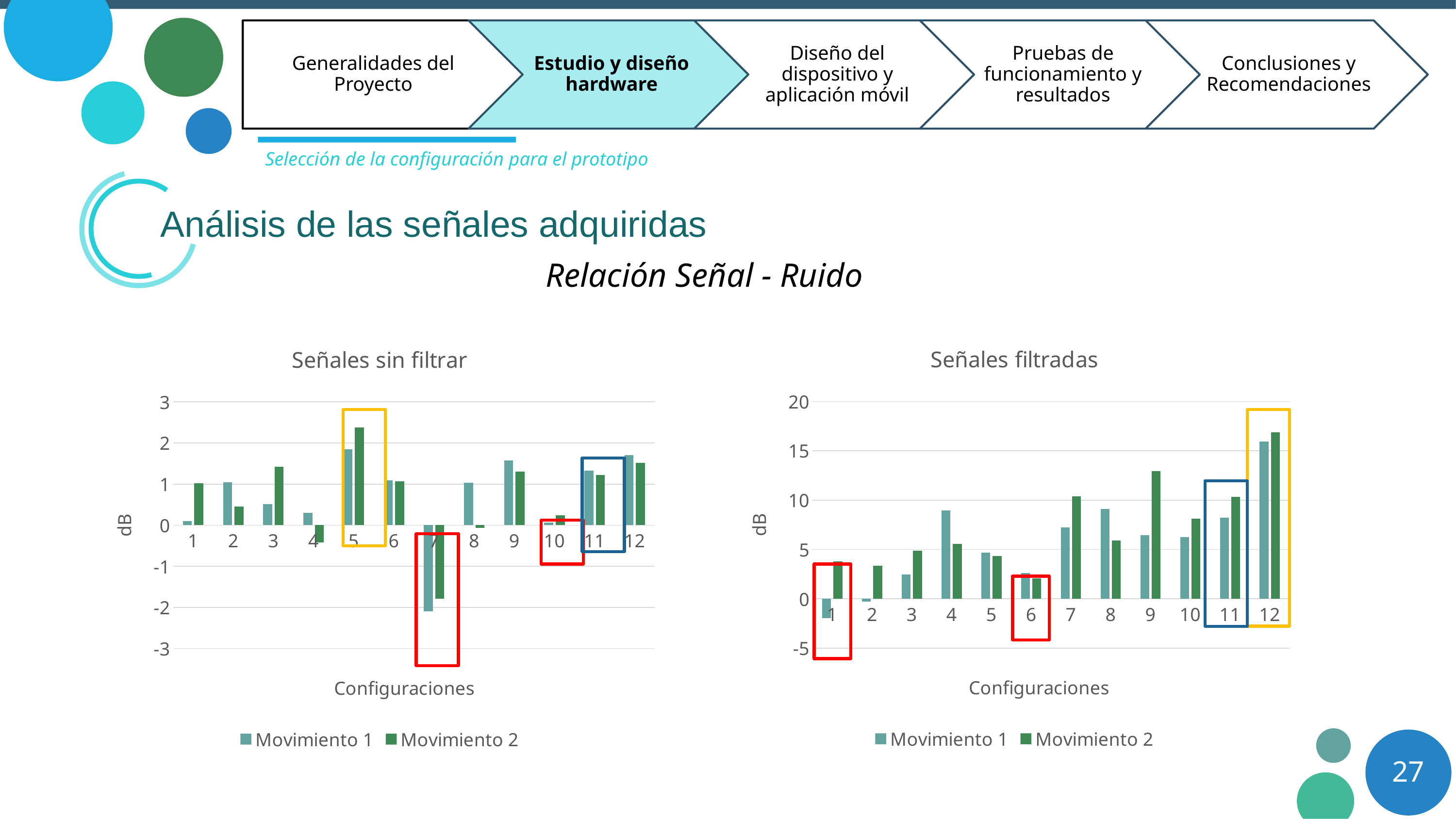
In the "Señales filtradas" chart, which configuration has the highest Movimiento 2 value? 12 How many configurations are shown on the x axis of the "Señales filtradas" chart? 12 What kind of chart is the "Señales sin filtrar" chart? bar chart In the "Señales sin filtrar" chart, which configuration has the highest Movimiento 2 value? 5 In the "Señales filtradas" chart, for configuration 7, which series has the larger value, Movimiento 1 or Movimiento 2? Movimiento 2 How many series does the legend of the "Señales sin filtrar" chart list? 2 In the "Señales filtradas" chart, is the Movimiento 2 value for configuration 12 greater or less than 15? greater What is the y-axis label of the "Señales filtradas" chart? dB In the "Señales filtradas" chart, which configuration has the lowest Movimiento 1 value? 1 In the "Señales sin filtrar" chart, which configuration has the lowest Movimiento 1 value? 7 In the "Señales sin filtrar" chart, for configuration 3, which series has the larger value, Movimiento 1 or Movimiento 2? Movimiento 2 In the "Señales sin filtrar" chart, is the Movimiento 1 value for configuration 7 greater or less than -1? less